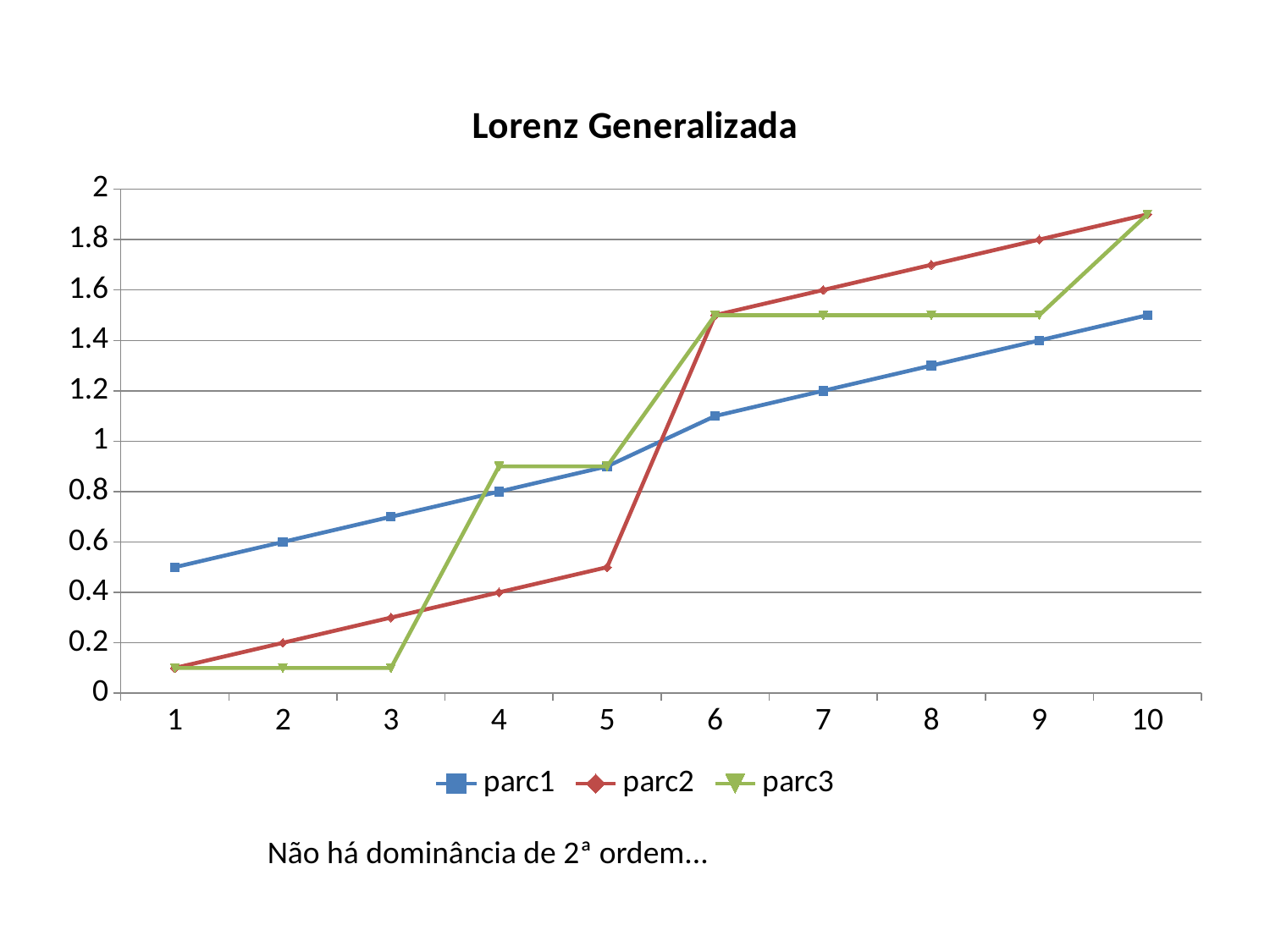
At x = 5, which is larger, parc1 or parc2? parc1 What is the value of parc2 at x = 9? 1.8 Do the values of parc1 rise or fall from x = 1 to x = 10? rise What kind of chart is shown on the slide? line chart What is the value of parc1 at x = 2? 0.6 What is the difference between parc2 and parc1 at x = 9? 0.4 Which series has the highest value at x = 1? parc1 What is the title of the chart? Lorenz Generalizada Is the value for parc3 at x = 8 greater or less than 1.4? greater How many series does the legend list? 3 What is the value of parc1 at x = 7? 1.2 How many points are plotted along the x axis for each series? 10